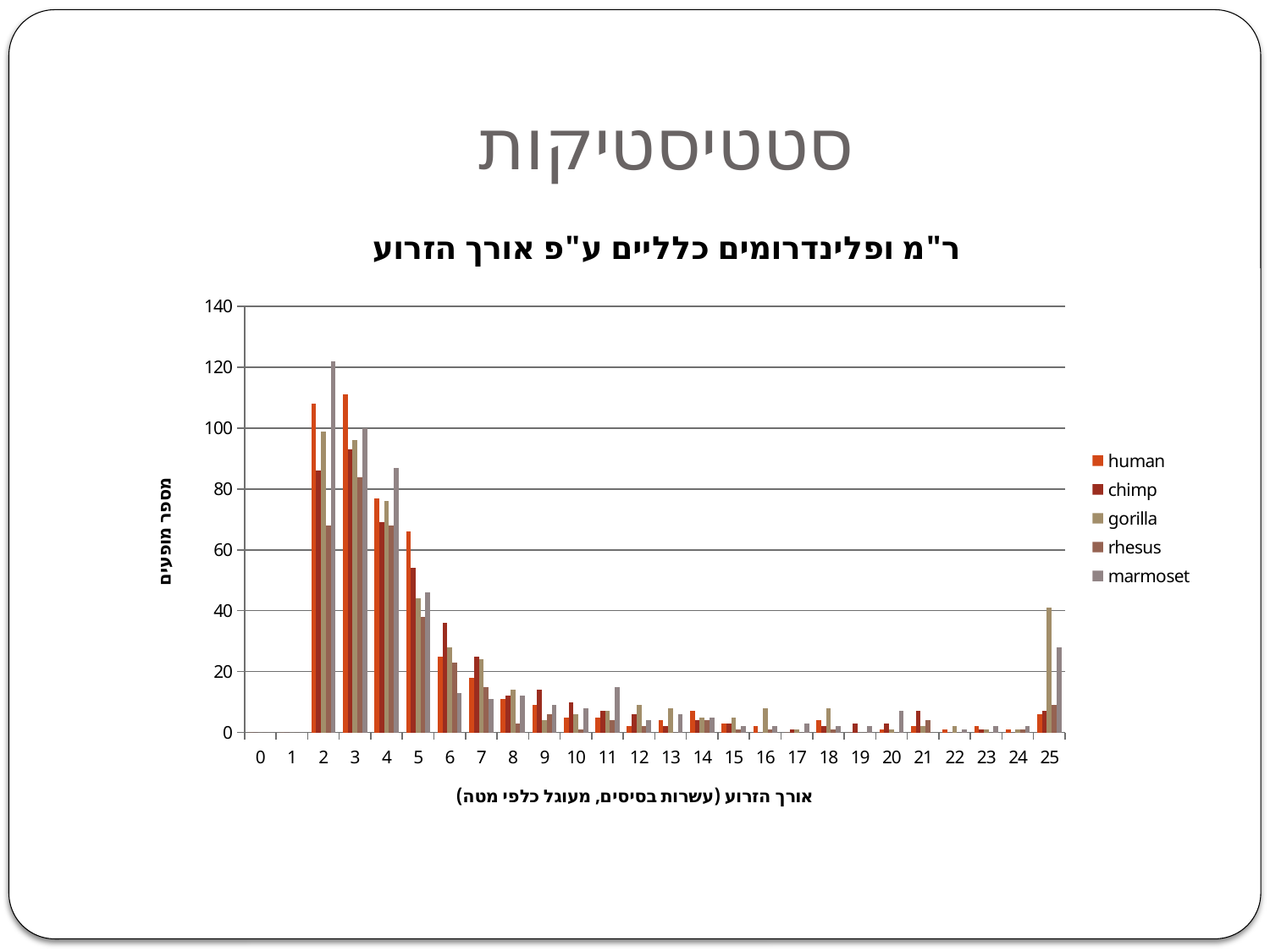
What kind of chart is shown on the slide? bar chart At x = 2, which is larger: the human value or the rhesus value? human Is the value for human at x = 2 greater or less than 100? greater Which series has the highest value at x = 2? marmoset Is the value for rhesus at x = 2 greater or less than 80? less Which series has the highest value at x = 3? human Do the human values generally rise or fall from x = 2 to x = 10? fall How many series does the legend list? 5 Which series are listed in the legend? human, chimp, gorilla, rhesus, marmoset How many categories are shown along the x axis? 26 Is the value for chimp at x = 6 greater or less than 40? less Which series has the highest value at x = 25? gorilla